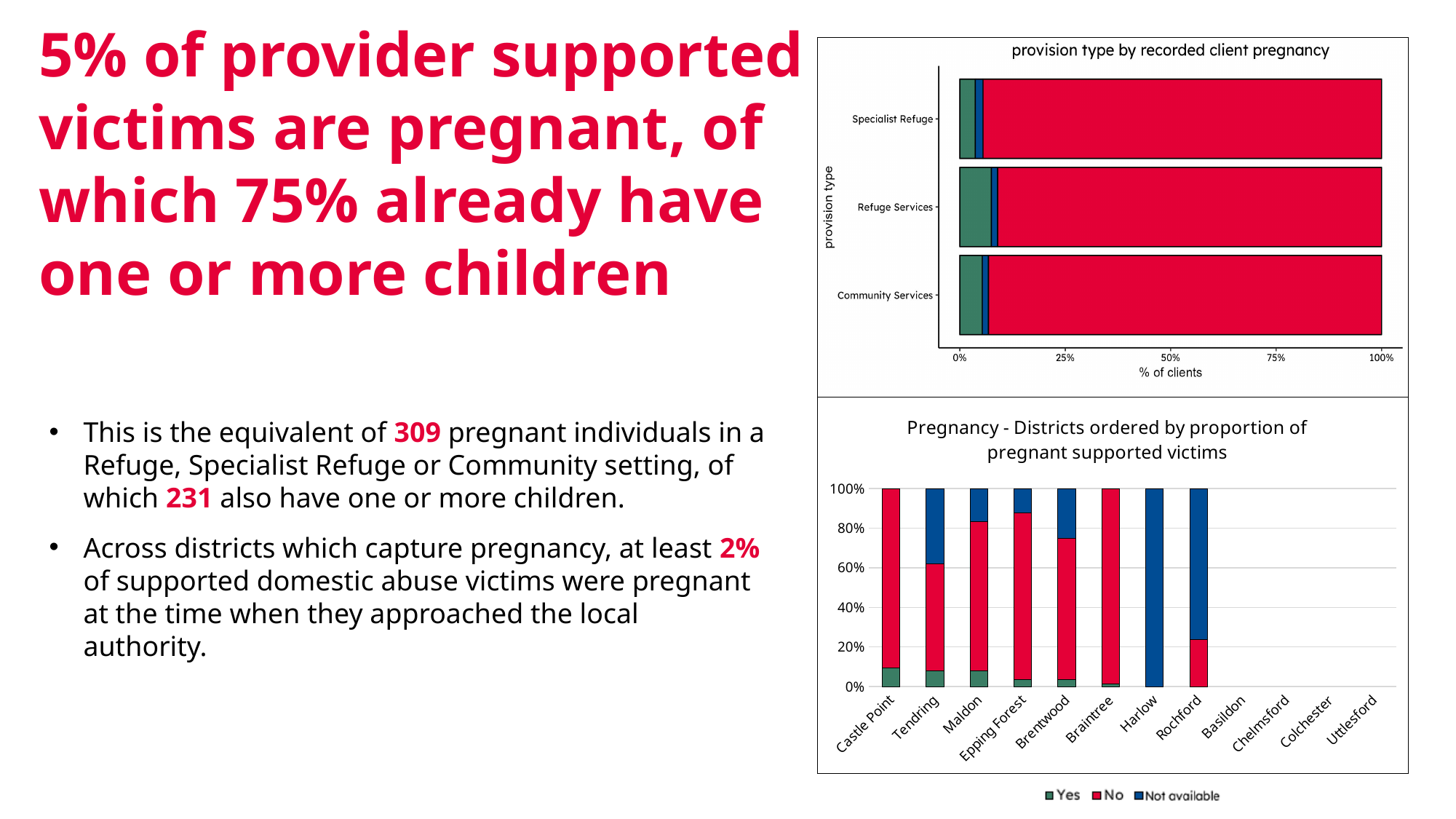
In the top chart 'provision type by recorded client pregnancy', which has the larger 'Yes' share: Refuge Services or Specialist Refuge? Refuge Services What is the x-axis label of the top chart 'provision type by recorded client pregnancy'? % of clients What kind of chart is the top chart titled 'provision type by recorded client pregnancy'? Stacked bar chart In the bottom chart 'Pregnancy - Districts ordered by proportion of pregnant supported victims', is the 'Not available' share for Rochford greater or less than 60%? greater How many provision types are shown in the top chart 'provision type by recorded client pregnancy'? 3 In the bottom chart 'Pregnancy - Districts ordered by proportion of pregnant supported victims', which district has the largest 'Not available' share? Harlow In the bottom chart 'Pregnancy - Districts ordered by proportion of pregnant supported victims', which district has the larger 'Yes' share: Castle Point or Braintree? Castle Point In the top chart 'provision type by recorded client pregnancy', is the 'No' share for Specialist Refuge greater or less than 75%? greater How many series does the legend of the bottom chart 'Pregnancy - Districts ordered by proportion of pregnant supported victims' list? 3 In the bottom chart 'Pregnancy - Districts ordered by proportion of pregnant supported victims', is the 'Yes' share for Castle Point greater or less than 20%? less How many districts are listed on the x axis of the bottom chart 'Pregnancy - Districts ordered by proportion of pregnant supported victims'? 12